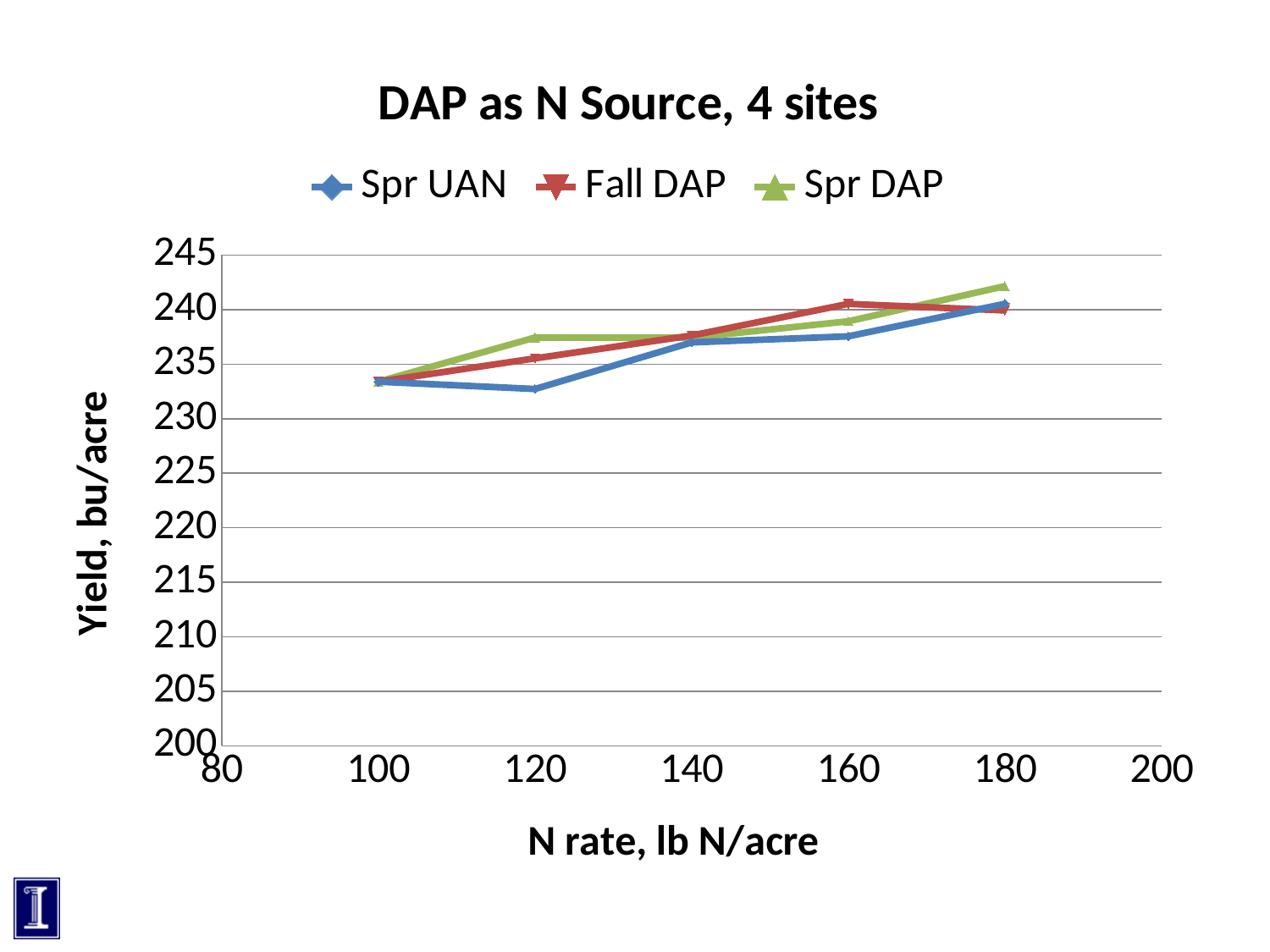
Is the Spr DAP yield at an N rate of 180 greater or less than 240? greater Which series has the lowest yield at an N rate of 120? Spr UAN How many N rate points are plotted for each series? 5 How many series does the legend list? 3 Does the Spr DAP yield generally rise or fall as the N rate increases from 100 to 180? rise Is the Fall DAP yield at an N rate of 160 greater or less than 235? greater Is the Spr DAP yield at an N rate of 120 greater or less than 235? greater What is the title of the chart? DAP as N Source, 4 sites Which series has the highest yield at an N rate of 180? Spr DAP At an N rate of 120, which series has the higher yield, Spr DAP or Spr UAN? Spr DAP What kind of chart is shown on the slide? line chart